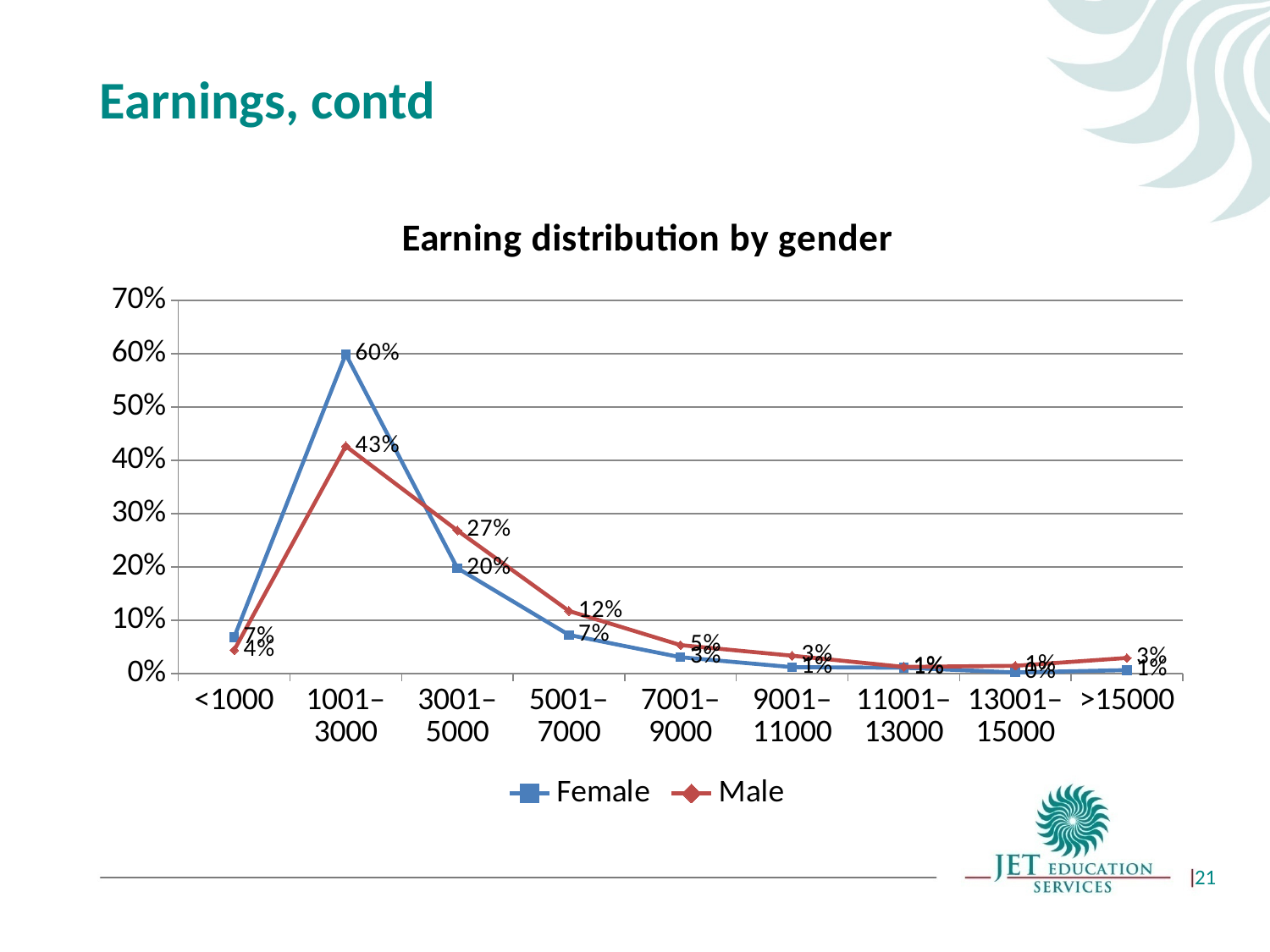
What is the Male value for the 1001–3000 category? 43% What is the difference between the Female and Male values in the 1001–3000 category? 17% In the 3001–5000 category, which series has the larger value, Female or Male? Male What is the Female value for the 3001–5000 category? 20% What is the title of the chart? Earning distribution by gender How many series does the legend list? 2 Which category has the highest Female value? 1001–3000 What is the Male value for the 5001–7000 category? 12% How many earnings categories are shown on the x axis? 9 What is the Female value for the 1001–3000 category? 60% What type of chart is shown on the slide? line chart What is the Male value for the 3001–5000 category? 27%